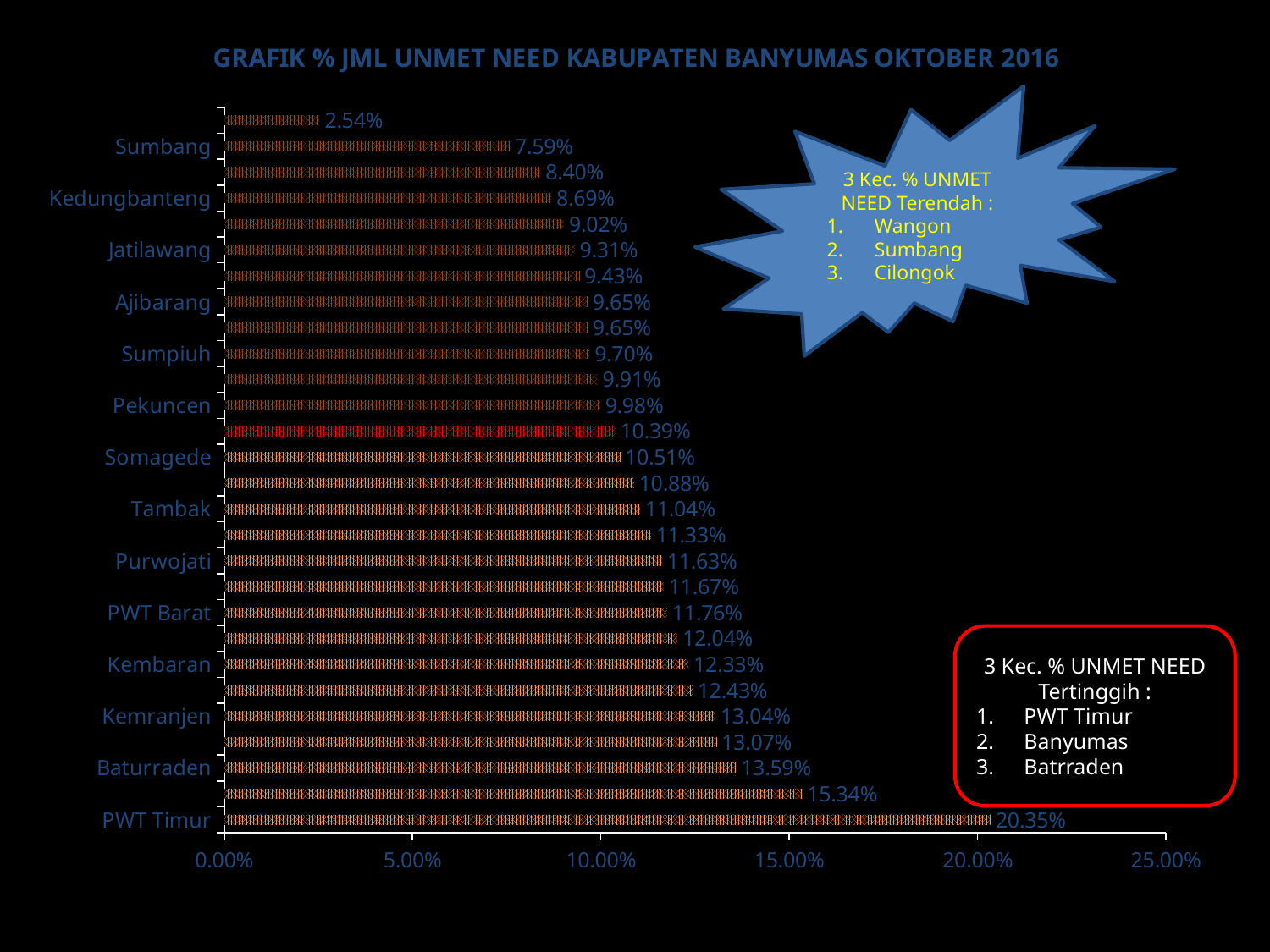
What is the % unmet need value for Sumbang? 7.59% What is the % unmet need value for Kedungbanteng? 8.69% How many bars are plotted in the chart? 28 Is the value for Purwojati greater or less than 10.00%? greater Which has a higher % unmet need, Kembaran or Tambak? Kembaran What is the lowest value shown on the chart? 2.54% What is the % unmet need value for PWT Timur? 20.35% What type of chart is shown on the slide? bar chart Which kecamatan has the highest % unmet need in the chart? PWT Timur What is the difference between the values for PWT Timur and Baturraden? 6.76% What is the % unmet need value for Kemranjen? 13.04% What is the % unmet need value for Baturraden? 13.59%